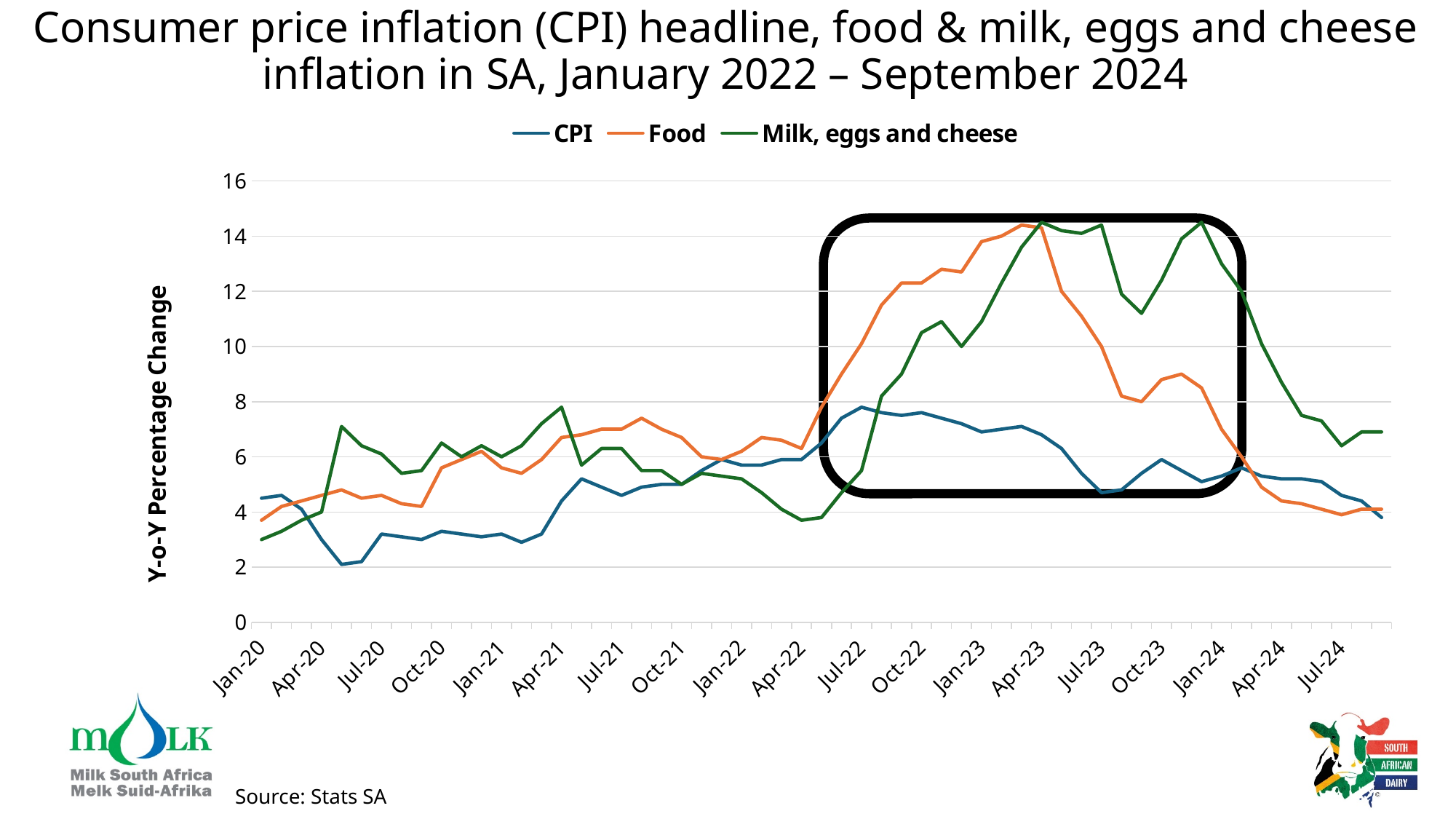
How many series does the legend list? 3 What kind of chart is shown on the slide? Line chart Is the value for Food at Oct-22 greater or less than 10? greater What colour is the Food line in the chart? Orange What is the label on the y-axis of the chart? Y-o-Y Percentage Change Does the Food series rise or fall between Apr-23 and Jul-24? Fall Is the value for Milk, eggs and cheese at Jan-24 greater or less than 12? greater At Jul-23, which is larger: CPI or Milk, eggs and cheese? Milk, eggs and cheese Which series has the lowest value at Jan-24? CPI At Jan-24, which is larger: Milk, eggs and cheese or Food? Milk, eggs and cheese Is the value for CPI at Jul-22 greater or less than 6? greater